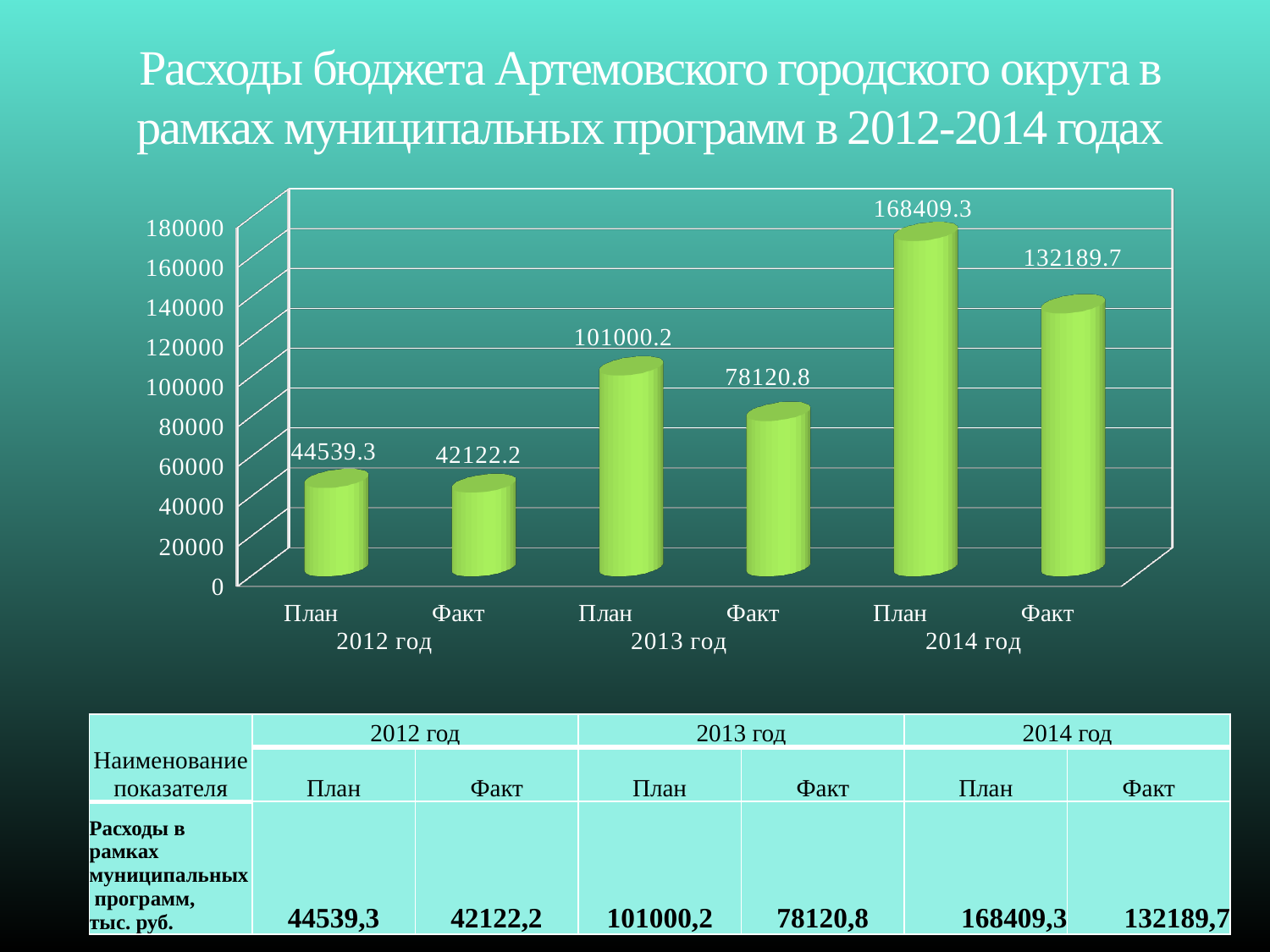
What type of chart is shown on the slide? bar chart What is the value of the Факт bar for 2013 год? 78120.8 What is the value of the План bar for 2012 год? 44539.3 Do the План values rise or fall from 2012 год to 2014 год? rise Which bar has the highest value? План, 2014 год What is the difference between the План and Факт values for 2014 год? 36219.6 Which is larger: the Факт value for 2013 год or the План value for 2012 год? Факт for 2013 год Is the Факт value for 2014 год greater or less than 120000? greater How many bars are plotted in the chart? 6 What is the difference between the План and Факт values for 2013 год? 22879.4 What is the value of the Факт bar for 2014 год? 132189.7 Which bar has the lowest value? Факт, 2012 год